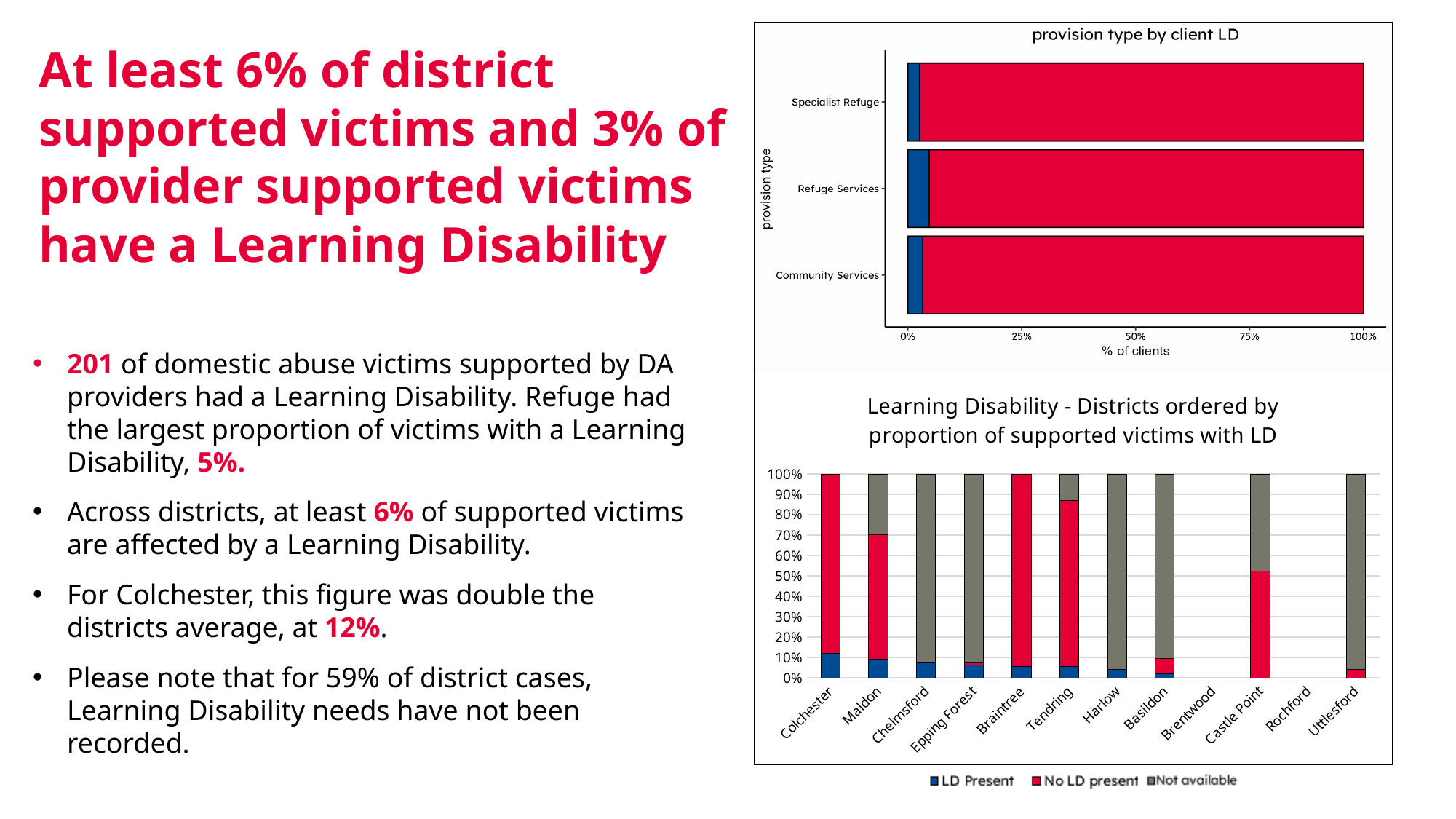
In the bottom chart 'Learning Disability - Districts ordered by proportion of supported victims with LD', is the Not available share for Tendring greater or less than 25%? less In the top chart 'provision type by client LD', which provision type has the largest LD present (blue) share? Refuge Services How many provision types are shown in the top chart 'provision type by client LD'? 3 In the top chart 'provision type by client LD', is the No LD present share for Specialist Refuge greater or less than 75%? greater In the bottom chart 'Learning Disability - Districts ordered by proportion of supported victims with LD', which district has the highest LD Present share? Colchester How many districts are listed on the x axis of the bottom chart 'Learning Disability - Districts ordered by proportion of supported victims with LD'? 12 In the bottom chart 'Learning Disability - Districts ordered by proportion of supported victims with LD', is the LD Present share for Colchester greater or less than 10%? greater What kind of chart is the top chart titled 'provision type by client LD'? bar chart In the bottom chart 'Learning Disability - Districts ordered by proportion of supported victims with LD', which has the larger LD Present share, Colchester or Maldon? Colchester What is the x-axis label of the top chart 'provision type by client LD'? % of clients How many series does the legend of the bottom chart 'Learning Disability - Districts ordered by proportion of supported victims with LD' list? 3